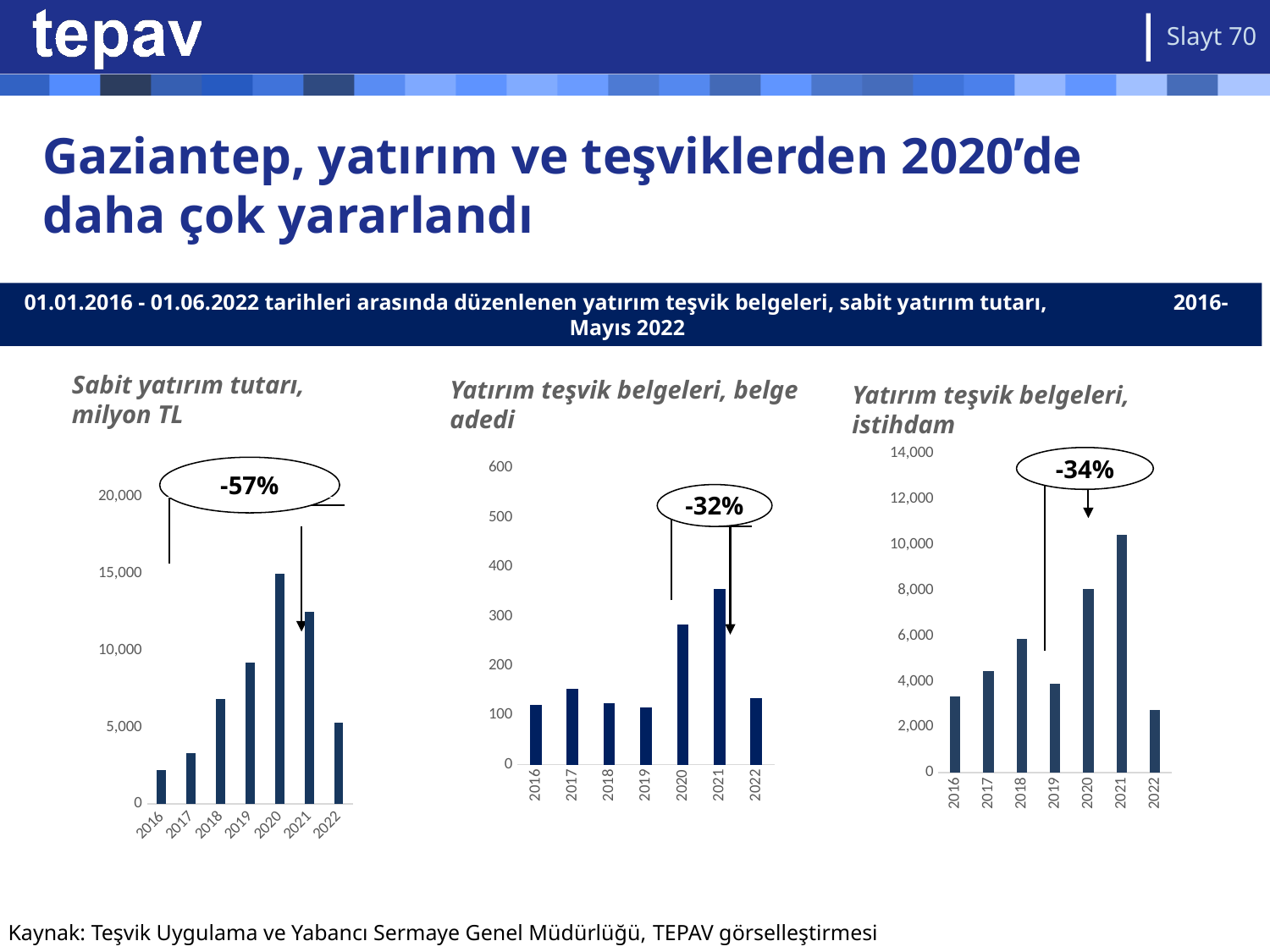
In the 'Sabit yatırım tutarı, milyon TL' chart, how many years are plotted? 7 How many charts are shown on the slide? 3 In the 'Yatırım teşvik belgeleri, istihdam' chart, is the value for 2020 greater or less than 6,000? greater In the 'Yatırım teşvik belgeleri, belge adedi' chart, is the value for 2017 greater or less than 200? less In the 'Yatırım teşvik belgeleri, istihdam' chart, which year has the highest value? 2021 In the 'Yatırım teşvik belgeleri, belge adedi' chart, which year has the highest value? 2021 In the 'Sabit yatırım tutarı, milyon TL' chart, which year has the lowest value? 2016 In the 'Sabit yatırım tutarı, milyon TL' chart, what percentage change is shown in the annotation? -57% What kind of chart is the 'Sabit yatırım tutarı, milyon TL' chart? bar chart In the 'Sabit yatırım tutarı, milyon TL' chart, is the value for 2021 greater or less than 10,000? greater In the 'Sabit yatırım tutarı, milyon TL' chart, which year has the highest value? 2020